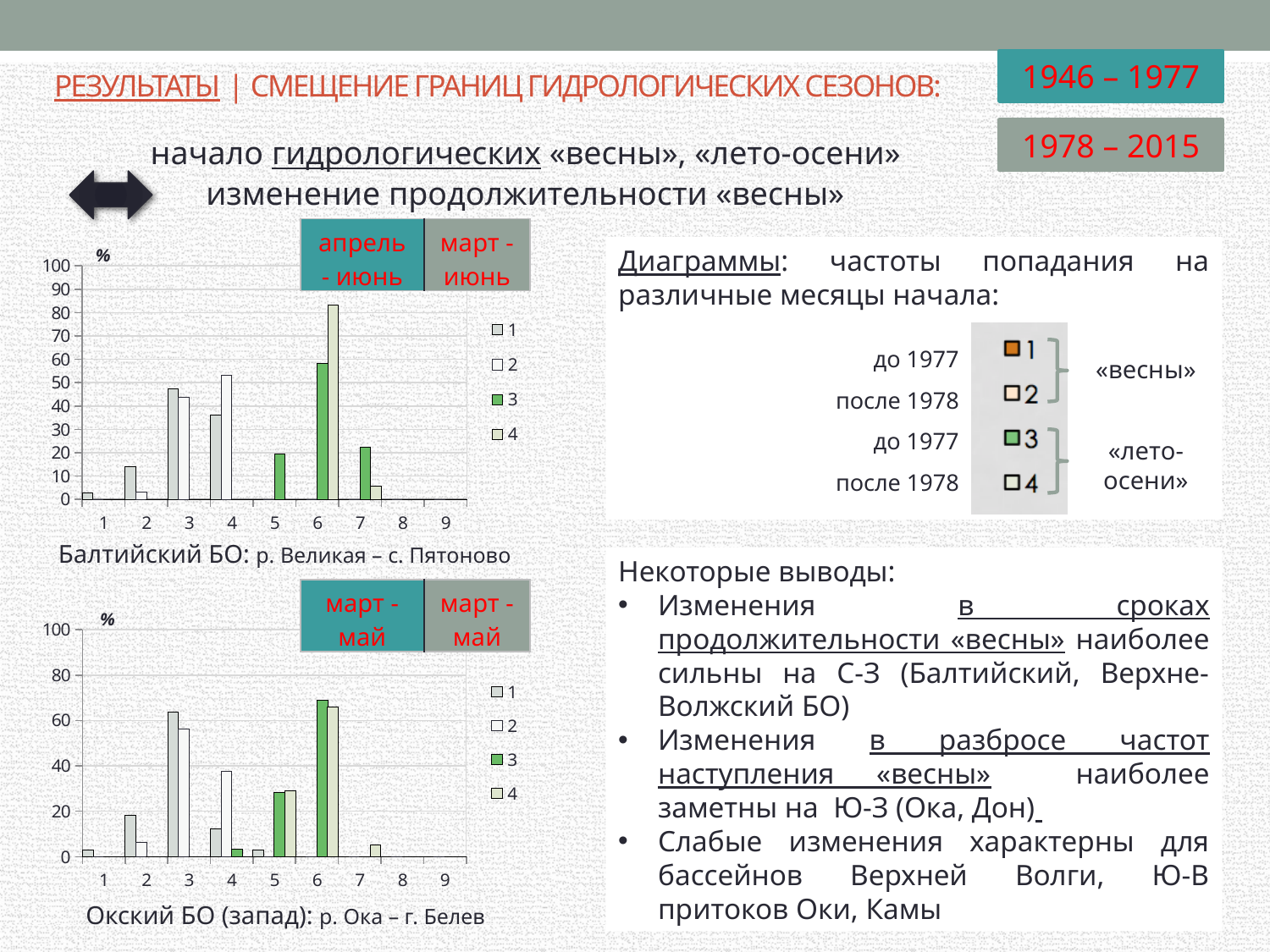
In the top chart (Балтийский БО), is the value of series 4 at category 6 greater or less than 70? greater What type of chart is the top chart (Балтийский БО: р. Великая – с. Пятоново)? bar chart In the bottom chart (Окский БО (запад)), at category 3, which is larger: series 1 or series 2? series 1 How many categories are shown on the x axis of the top chart (Балтийский БО)? 9 What unit is shown on the y axis of the top chart (Балтийский БО)? % In the top chart (Балтийский БО), is the value of series 3 at category 6 greater or less than 50? greater In the top chart (Балтийский БО), at category 4, which is larger: series 1 or series 2? series 2 In the top chart (Балтийский БО), which series has the tallest bar overall? 4 In the top chart (Балтийский БО), at which x-axis category is the tallest bar located? 6 In the bottom chart (Окский БО (запад)), is the value of series 3 at category 6 greater or less than 60? greater How many series does the legend of the bottom chart (Окский БО (запад): р. Ока – г. Белев) list? 4